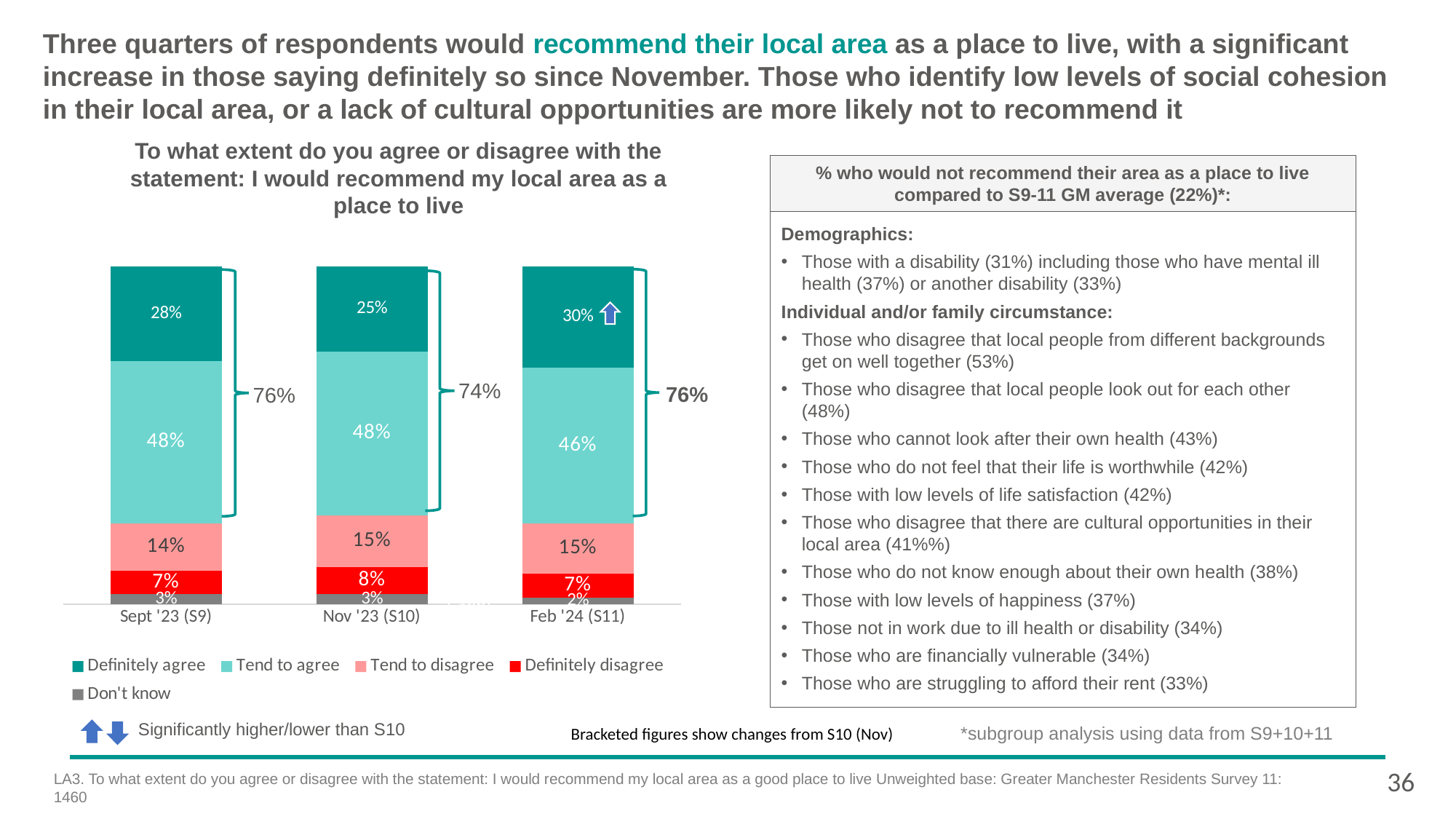
What is the combined share of 'Definitely agree' and 'Tend to agree' shown by the bracket for Nov '23 (S10)? 74% What percentage of respondents said 'Don't know' in Feb '24 (S11)? 2% What type of chart is used to show the agreement with the statement about recommending the local area? Stacked bar chart What percentage of respondents said 'Definitely disagree' in Nov '23 (S10)? 8% What percentage of respondents said 'Tend to agree' in Sept '23 (S9)? 48% In which survey wave was the 'Definitely agree' share lowest? Nov '23 (S10) What percentage of respondents said 'Definitely agree' in Feb '24 (S11)? 30% How many survey waves are shown on the x axis of the chart? 3 How many series does the chart legend list? 5 What is the difference in the 'Definitely agree' share between Feb '24 (S11) and Nov '23 (S10)? 5 percentage points Which is larger: the 'Tend to agree' share in Nov '23 (S10) or in Feb '24 (S11)? Nov '23 (S10) In which survey wave was the 'Definitely agree' share highest? Feb '24 (S11)